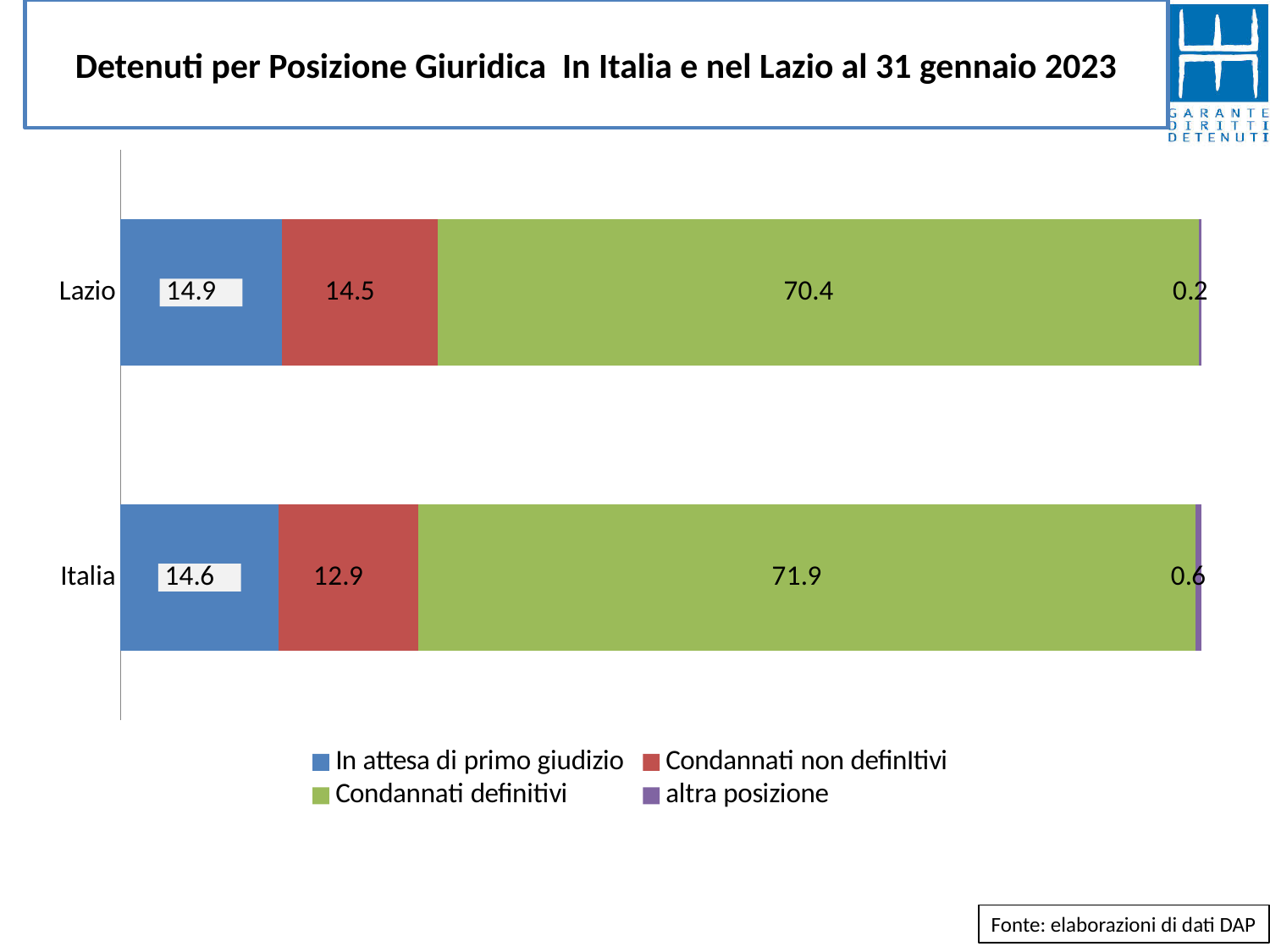
What is the difference between the 'Condannati non definItivi' values for Lazio and Italia? 1.6 What is the total of the stacked bar for Lazio? 100.0 What is the value for 'altra posizione' in Italia? 0.6 How many series does the legend list? 4 Which is larger, the 'Condannati definitivi' value for Lazio or for Italia? Italia How many categories (regions) are shown on the chart? 2 What is the value for 'Condannati non definItivi' in Lazio? 14.5 Which series has the smallest value in the Lazio bar? altra posizione What is the value for 'In attesa di primo giudizio' in Italia? 14.6 What kind of chart is shown on the slide? Stacked bar chart What is the value for 'Condannati definitivi' in Lazio? 70.4 Which series has the largest value in the Italia bar? Condannati definitivi